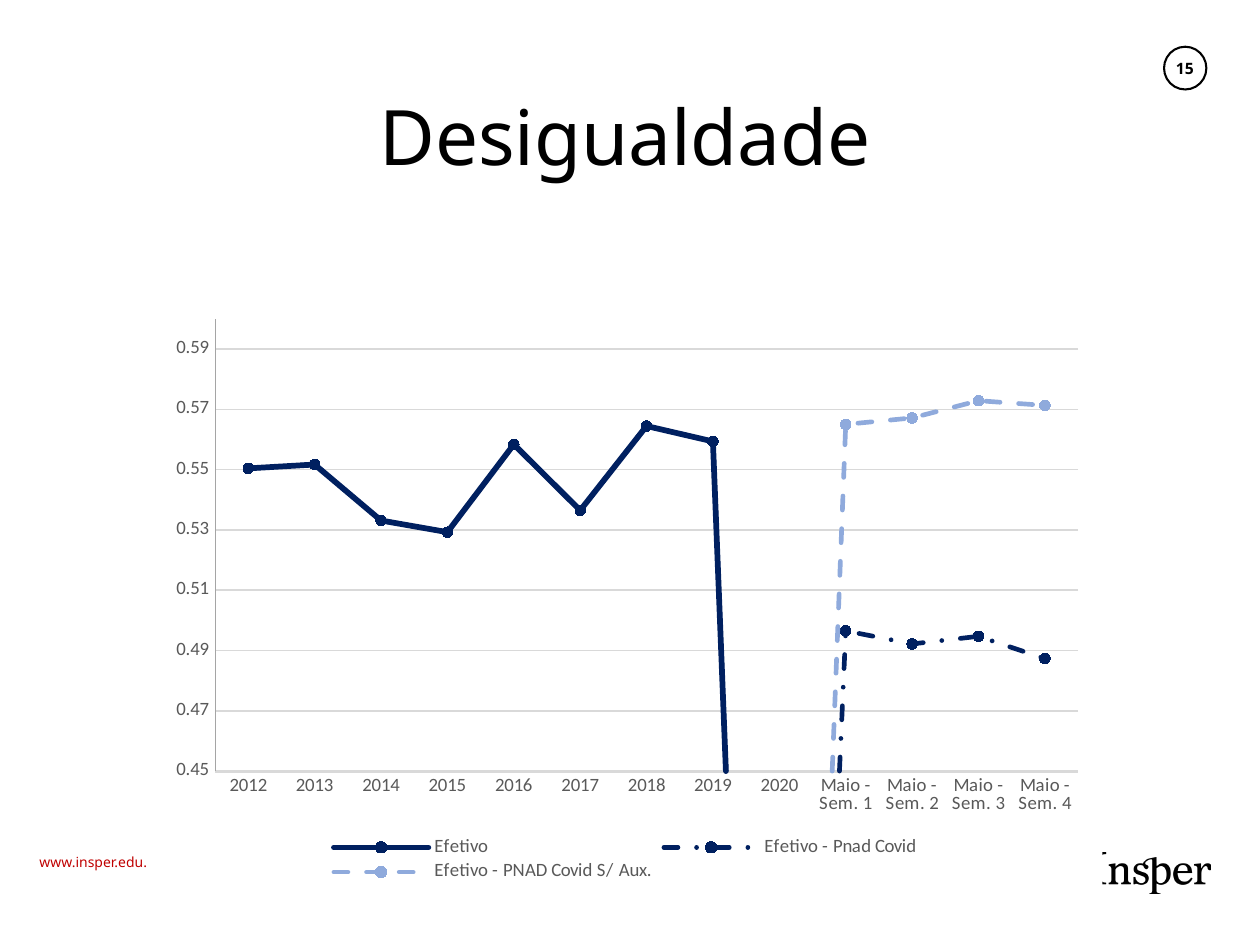
Which category has the highest value for the Efetivo - PNAD Covid S/ Aux. series? Maio - Sem. 3 What is the title of the chart? Desigualdade Which category has the lowest value for the Efetivo - Pnad Covid series? Maio - Sem. 4 Is the value of Efetivo - PNAD Covid S/ Aux. at Maio - Sem. 3 greater or less than 0.57? greater What kind of chart is shown on the slide? line chart How many categories are shown on the x axis? 13 In which year does the Efetivo series reach its highest value? 2018 Is the value of the Efetivo series in 2018 greater or less than 0.55? greater At Maio - Sem. 1, which series has the larger value: Efetivo - Pnad Covid or Efetivo - PNAD Covid S/ Aux.? Efetivo - PNAD Covid S/ Aux. Is the value of Efetivo - Pnad Covid at Maio - Sem. 4 greater or less than 0.49? less How many series does the legend list? 3